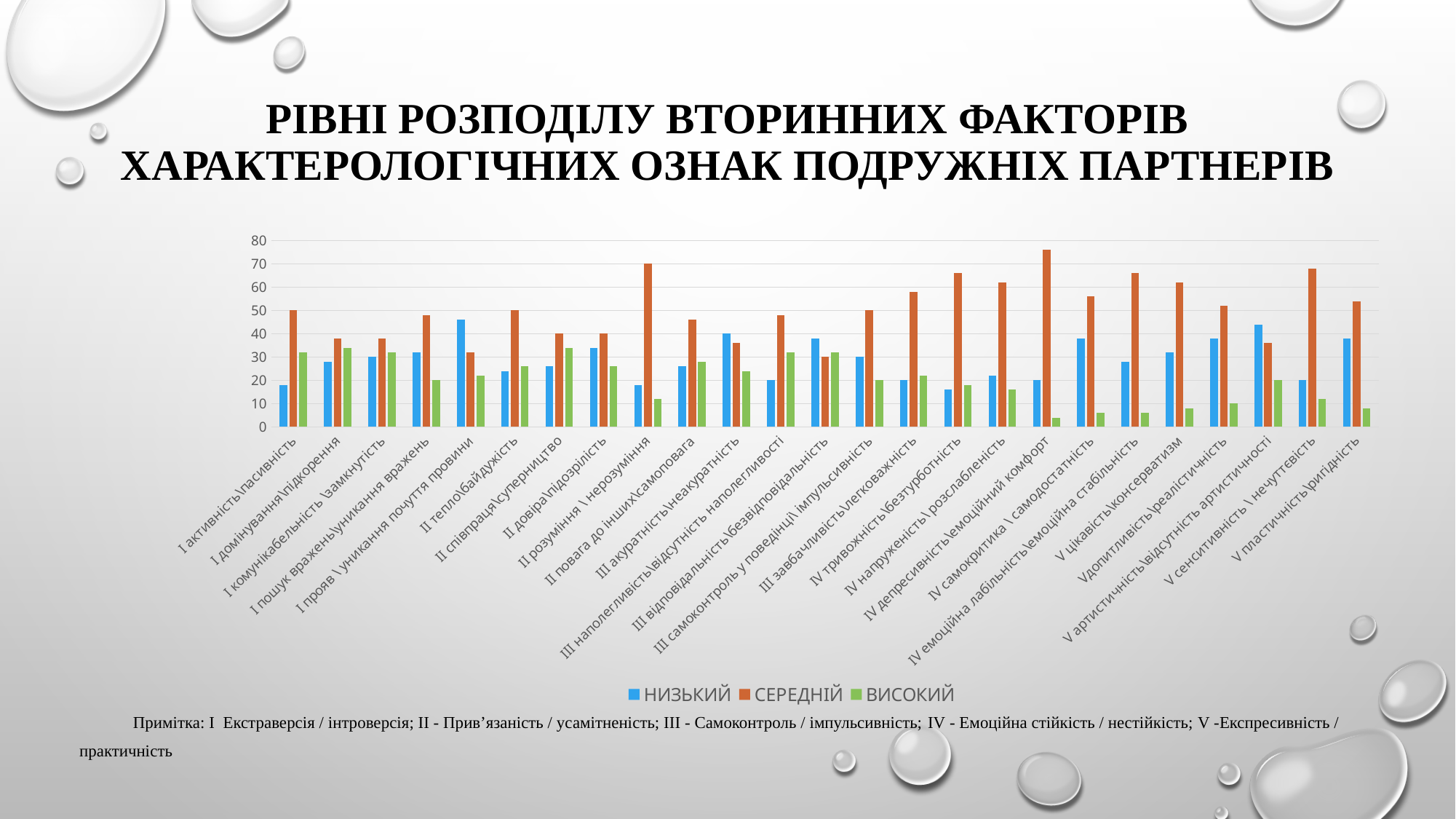
Which category has the highest СЕРЕДНІЙ value? IV депресивність\емоційний комфорт Which series is shown in orange in the legend? СЕРЕДНІЙ Is the СЕРЕДНІЙ value for IV депресивність\емоційний комфорт greater or less than 70? greater What kind of chart is shown on the slide? bar chart For I прояв \ уникання почуття провини, which is larger: the НИЗЬКИЙ value or the СЕРЕДНІЙ value? НИЗЬКИЙ Is the НИЗЬКИЙ value for IV тривожність\безтурботність greater or less than 20? less Which category has the lowest ВИСОКИЙ value? IV депресивність\емоційний комфорт How many categories are shown along the x axis? 25 How many series does the legend list? 3 Is the ВИСОКИЙ value for I домінування\підкорення greater or less than 30? greater For I активність\пасивність, which is larger: the НИЗЬКИЙ value or the СЕРЕДНІЙ value? СЕРЕДНІЙ